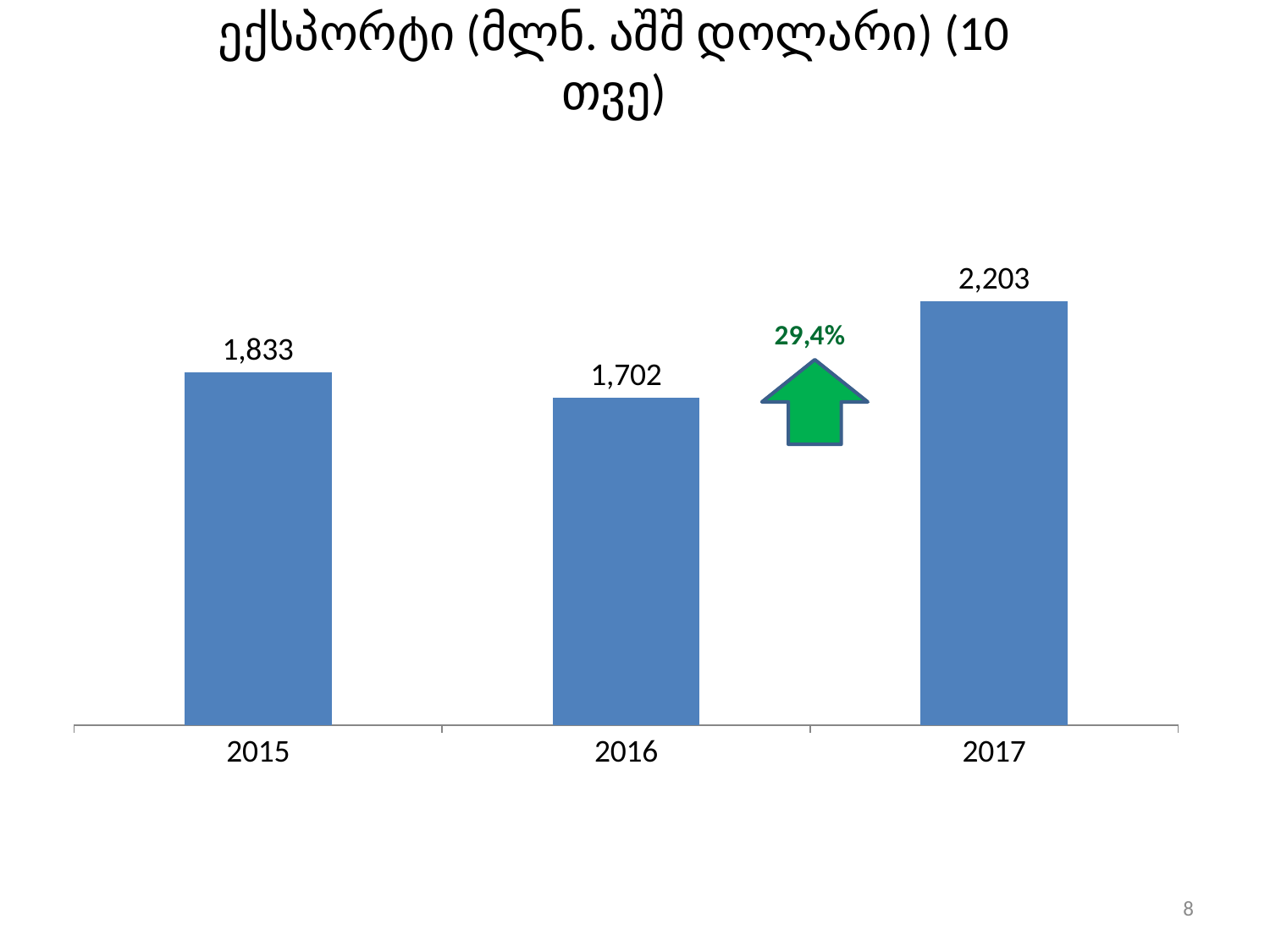
How many years are shown on the chart? 3 Which is larger, the export value for 2015 or for 2017? 2017 What is the difference between the export values for 2015 and 2016? 131 Which year has the highest export value? 2017 What is the export value shown for 2017? 2,203 Which year has the lowest export value? 2016 What is the export value shown for 2016? 1,702 What kind of chart is shown on the slide? bar chart What is the difference between the export values for 2017 and 2016? 501 What percentage change is shown next to the green arrow between 2016 and 2017? 29,4% What colour are the bars in the chart? blue What is the export value shown for 2015? 1,833